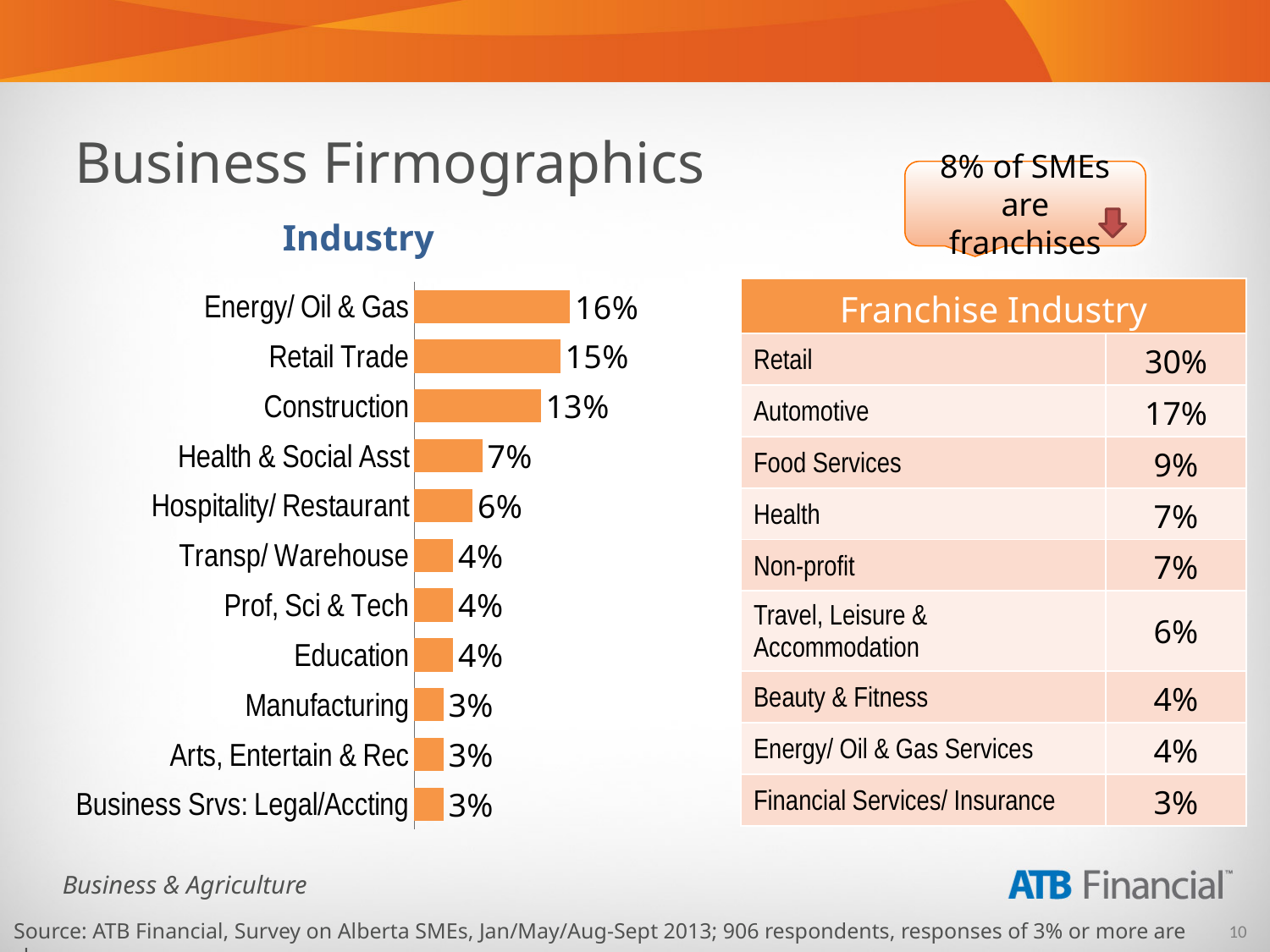
How many categories are shown in the Industry chart? 11 In the Industry chart, what is the value for Energy/ Oil & Gas? 16% In the Industry chart, which category has the highest value? Energy/ Oil & Gas What is the title of the chart on the left of the slide? Industry In the Industry chart, what is the difference between Energy/ Oil & Gas and Manufacturing? 13% In the Industry chart, what is the difference between Retail Trade and Construction? 2% In the Industry chart, what is the value for Health & Social Asst? 7% What kind of chart is the Industry chart? Bar chart In the Industry chart, what is the value for Construction? 13% In the Industry chart, which is larger, Retail Trade or Health & Social Asst? Retail Trade In the Industry chart, what is the value for Hospitality/ Restaurant? 6% In the Industry chart, which is larger, Hospitality/ Restaurant or Transp/ Warehouse? Hospitality/ Restaurant